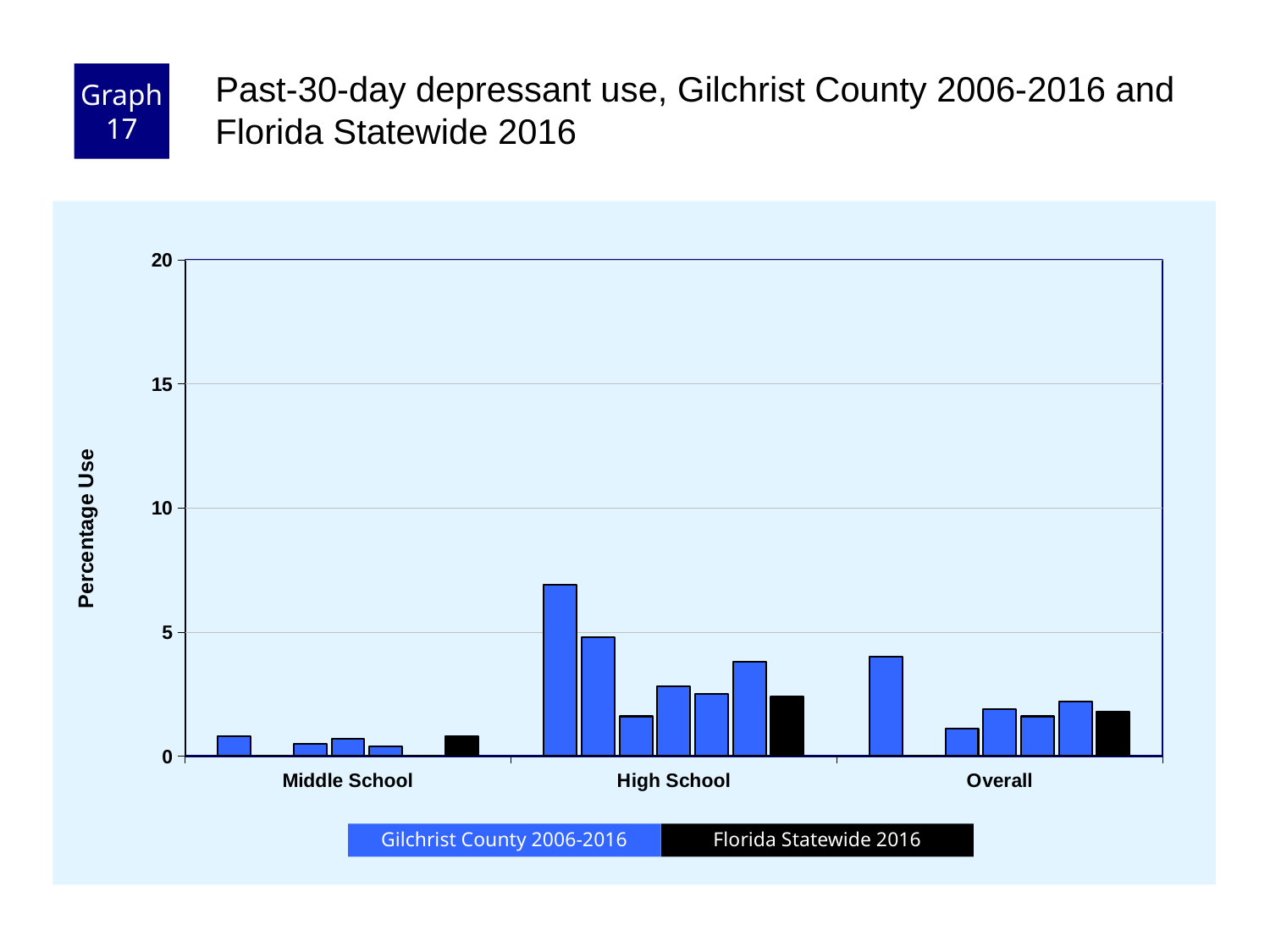
Is the Florida Statewide 2016 value for High School greater or less than 5? less What colour are the Florida Statewide 2016 bars? black Is the Florida Statewide 2016 value for Middle School greater or less than 5? less How many series does the legend list? 2 What kind of chart is shown on the slide? bar chart What is the label on the y axis? Percentage Use Which category contains the tallest bar in the chart? High School Which is larger, the Florida Statewide 2016 value for High School or for Middle School? High School Is the tallest Gilchrist County 2006-2016 bar for High School greater or less than 5? greater Which is larger, the Florida Statewide 2016 value for High School or for Overall? High School How many categories are shown on the x axis? 3